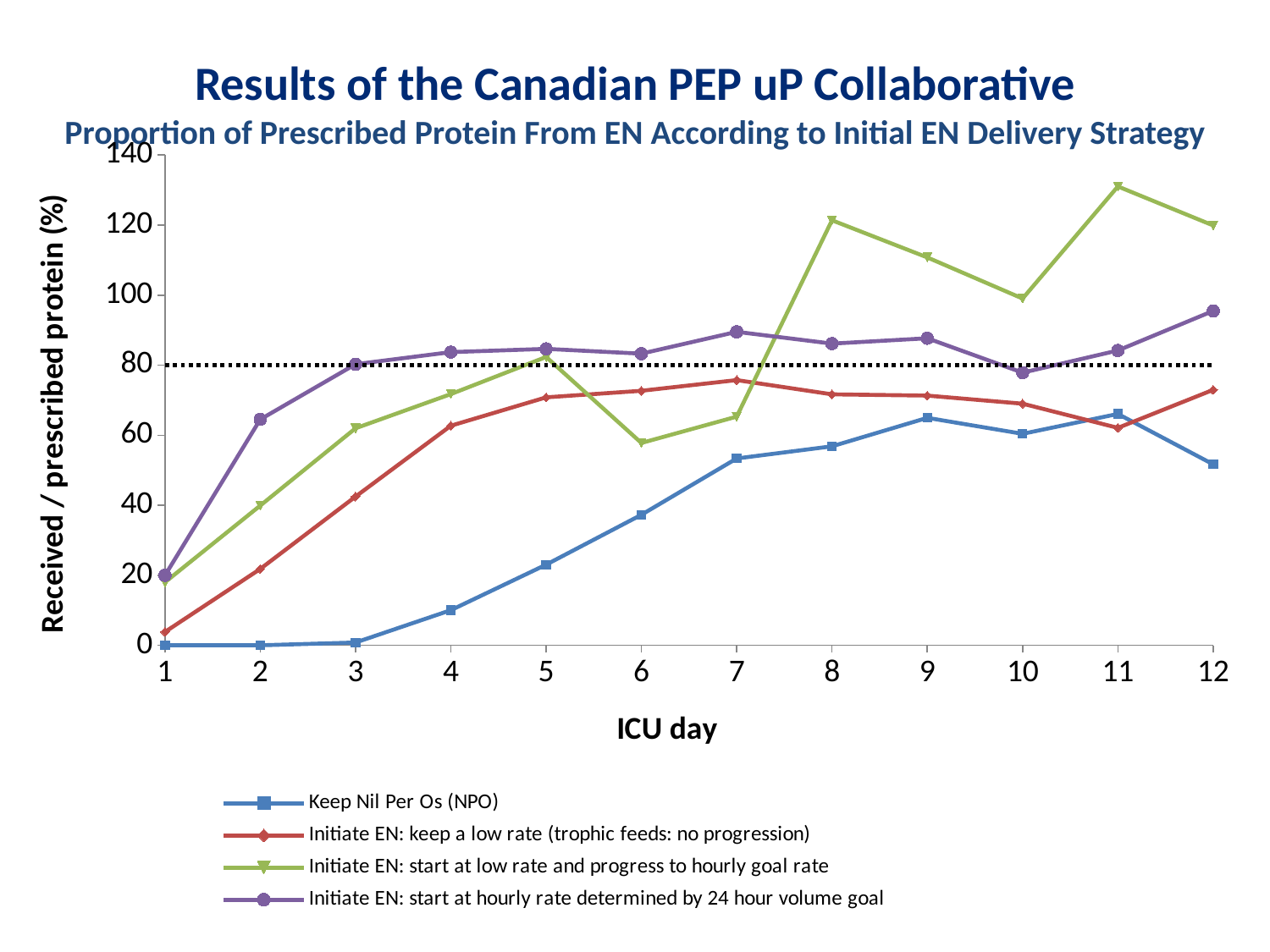
Which series has the highest value on ICU day 11? Initiate EN: start at low rate and progress to hourly goal rate Is the value for 'Initiate EN: start at hourly rate determined by 24 hour volume goal' on ICU day 7 greater or less than 80? greater Is the value for 'Initiate EN: start at low rate and progress to hourly goal rate' on ICU day 11 greater or less than 120? greater What kind of chart is shown on the slide? line chart What is the title of the x axis? ICU day How many ICU days are plotted along the x axis? 12 How many series does the legend list? 4 On ICU day 8, which is larger: 'Initiate EN: start at low rate and progress to hourly goal rate' or 'Initiate EN: start at hourly rate determined by 24 hour volume goal'? Initiate EN: start at low rate and progress to hourly goal rate Which series has the lowest value on ICU day 5? Keep Nil Per Os (NPO) Is the value for Keep Nil Per Os (NPO) on ICU day 12 greater or less than 60? less Does the Keep Nil Per Os (NPO) series rise or fall from ICU day 1 to ICU day 9? rise What is the value for Keep Nil Per Os (NPO) on ICU day 1? 0